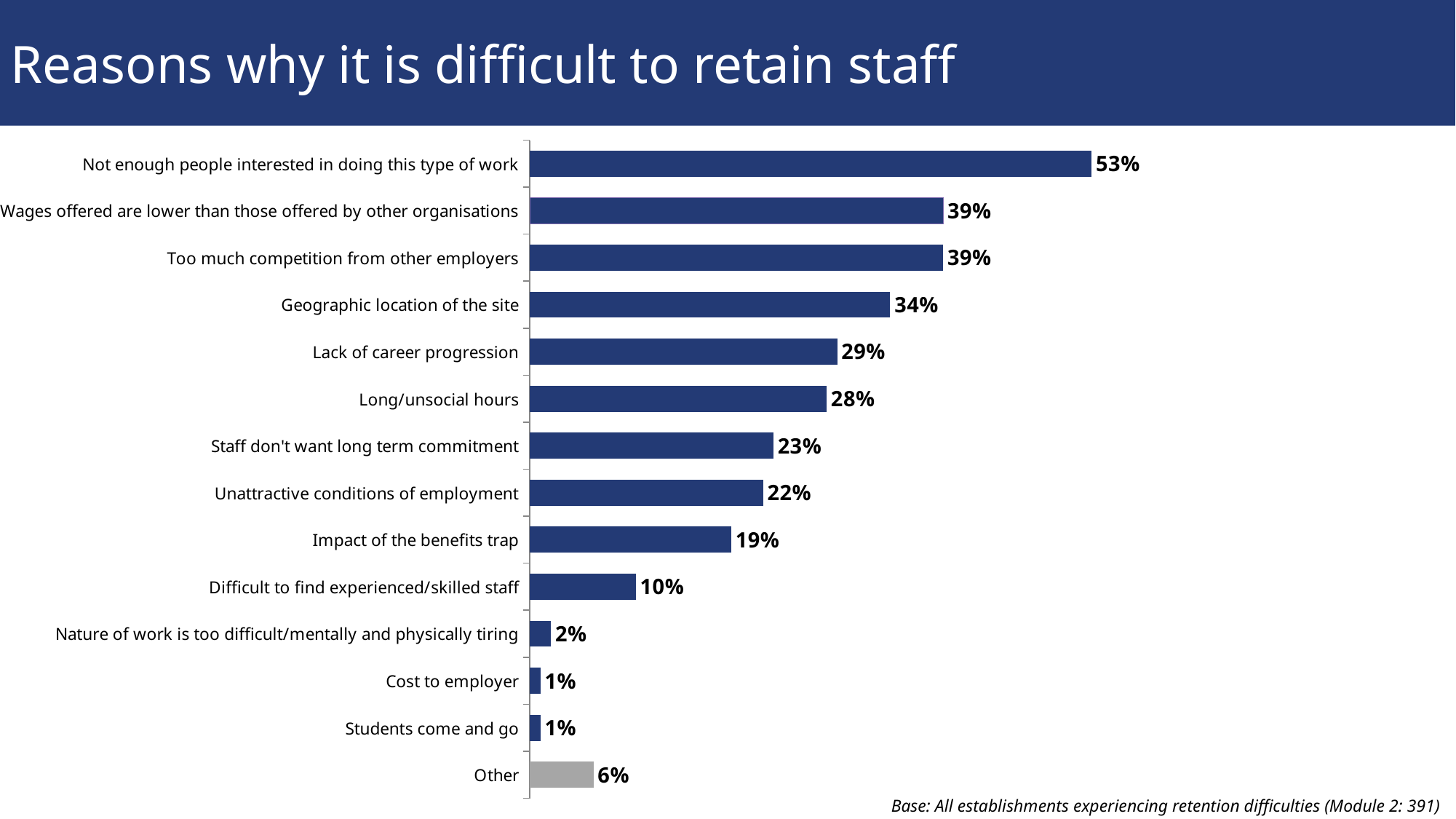
What is the difference between 'Lack of career progression' and 'Long/unsocial hours'? 1% What is the title of the chart? Reasons why it is difficult to retain staff What is the difference between 'Not enough people interested in doing this type of work' and 'Wages offered are lower than those offered by other organisations'? 14% Which reason has the highest percentage? Not enough people interested in doing this type of work What type of chart is shown on the slide? Bar chart What is the value for the 'Other' category? 6% What is the value for 'Geographic location of the site'? 34% Which bar is coloured grey rather than dark blue? Other What percentage is shown for 'Impact of the benefits trap'? 19% How many categories are shown in the chart? 14 What percentage is shown for 'Not enough people interested in doing this type of work'? 53% Which is larger: 'Staff don't want long term commitment' or 'Difficult to find experienced/skilled staff'? Staff don't want long term commitment